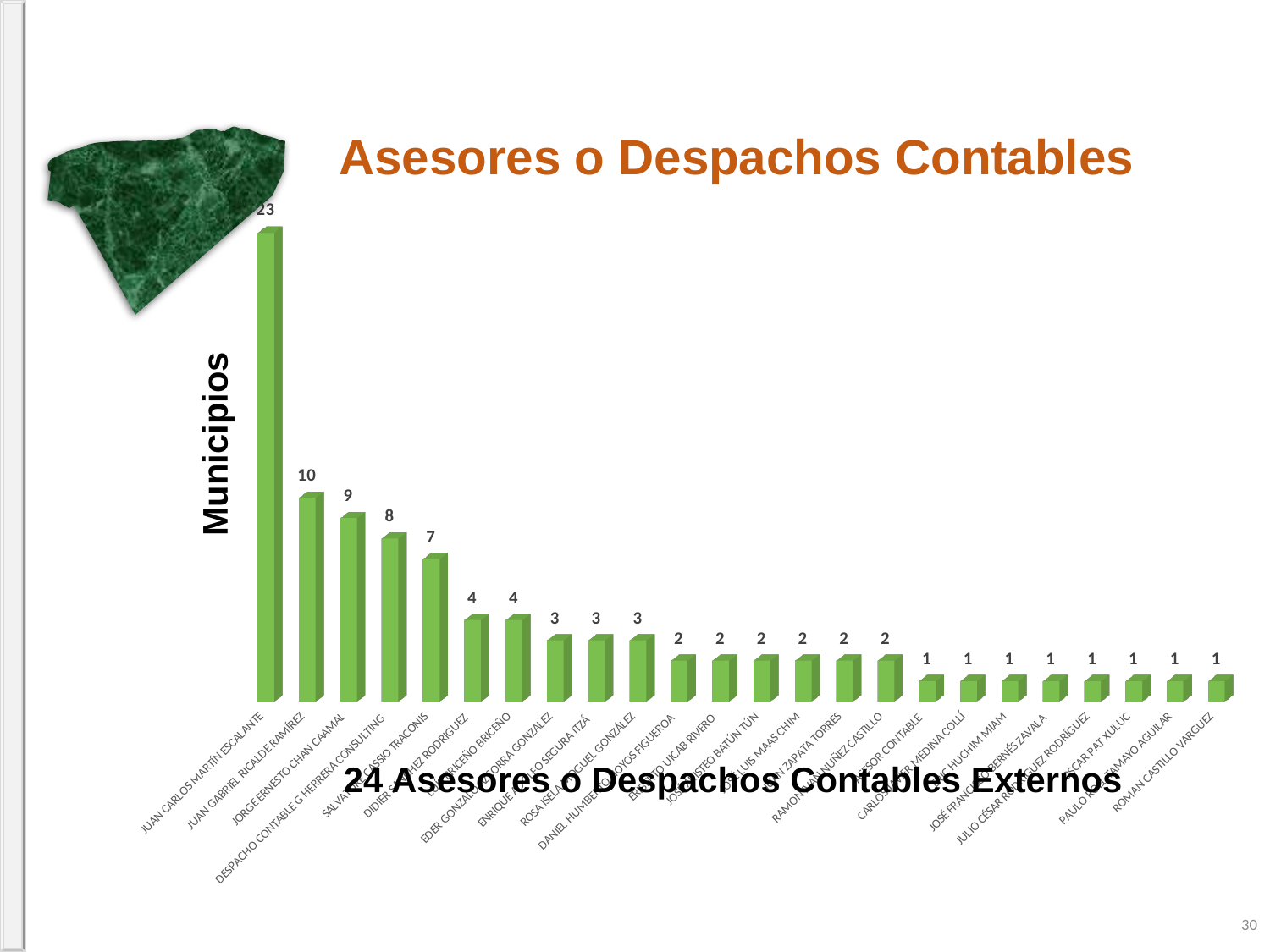
What is the value for JORGE ERNESTO CHAN CAAMAL? 9 What is the value for JUAN GABRIEL RICALDE RAMÍREZ? 10 What is the value for ROMAN CASTILLO VARGUEZ? 1 How many bars are plotted in the chart? 24 Which category has the highest value? JUAN CARLOS MARTÍN ESCALANTE What kind of chart is shown on the slide? bar chart Do the values rise or fall from left to right along the x axis? fall What is the value for JUAN CARLOS MARTÍN ESCALANTE? 23 What is the difference between the values for JUAN CARLOS MARTÍN ESCALANTE and JUAN GABRIEL RICALDE RAMÍREZ? 13 Which is larger, the value for JORGE ERNESTO CHAN CAAMAL or the value for DESPACHO CONTABLE G HERRERA CONSULTING? JORGE ERNESTO CHAN CAAMAL How many bars have a value of 1? 8 What is the value for DESPACHO CONTABLE G HERRERA CONSULTING? 8